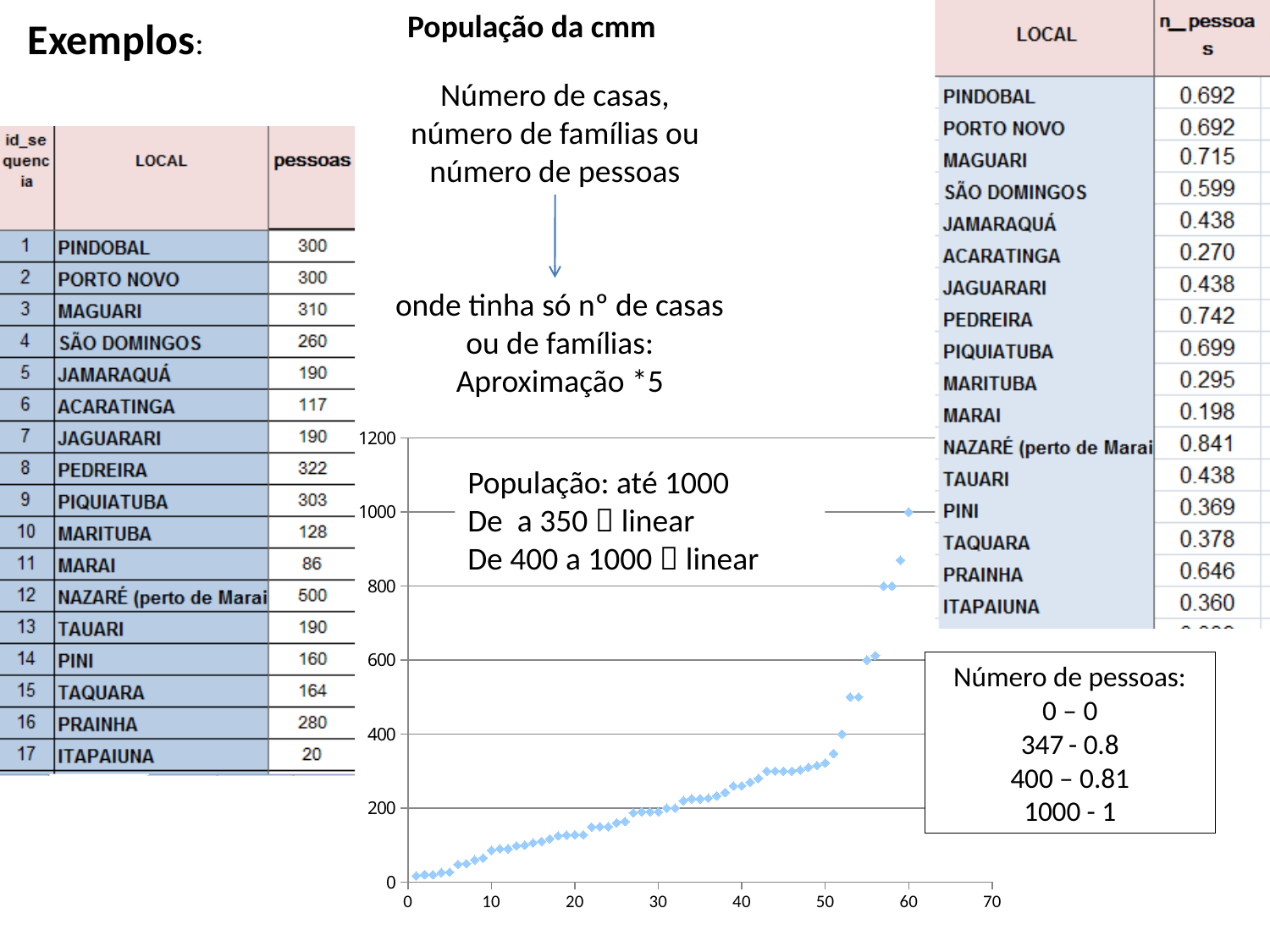
Are the points plotted around x = 10 greater or less than 200? less Are the points plotted around x = 54 greater or less than 400? greater What is the highest value shown on the x axis of the chart? 70 Do the plotted values rise or fall as the x axis increases? rise Is the highest plotted point greater or less than 800? greater What is the highest value shown on the y axis of the chart? 1200 What kind of chart is shown at the bottom of the slide? scatter chart